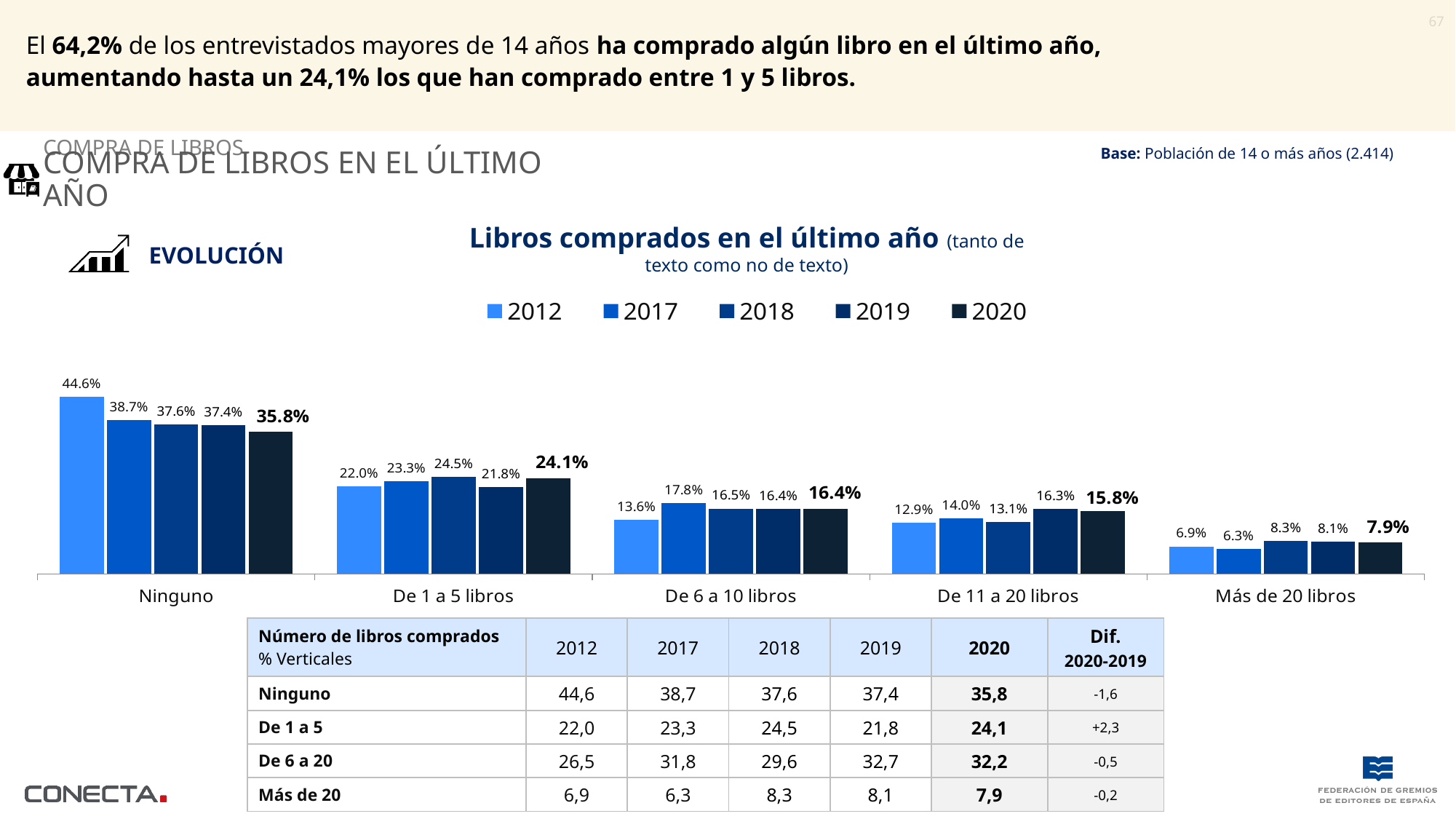
What is the value for "Más de 20 libros" in 2012? 6.9% How many series does the legend list? 5 What is the difference between the 2012 and 2020 values for "Ninguno"? 8.8% What is the value for "Ninguno" in 2020? 35.8% Which category has the highest value in 2012? Ninguno What kind of chart is shown on the slide? Bar chart What is the value for "De 11 a 20 libros" in 2019? 16.3% How many categories are shown on the x axis of the chart? 5 Which category has the lowest value in 2020? Más de 20 libros What is the value for "De 1 a 5 libros" in 2018? 24.5% Do the values for "Ninguno" rise or fall from 2012 to 2020? Fall Which is larger for "De 6 a 10 libros": the 2012 value or the 2017 value? 2017